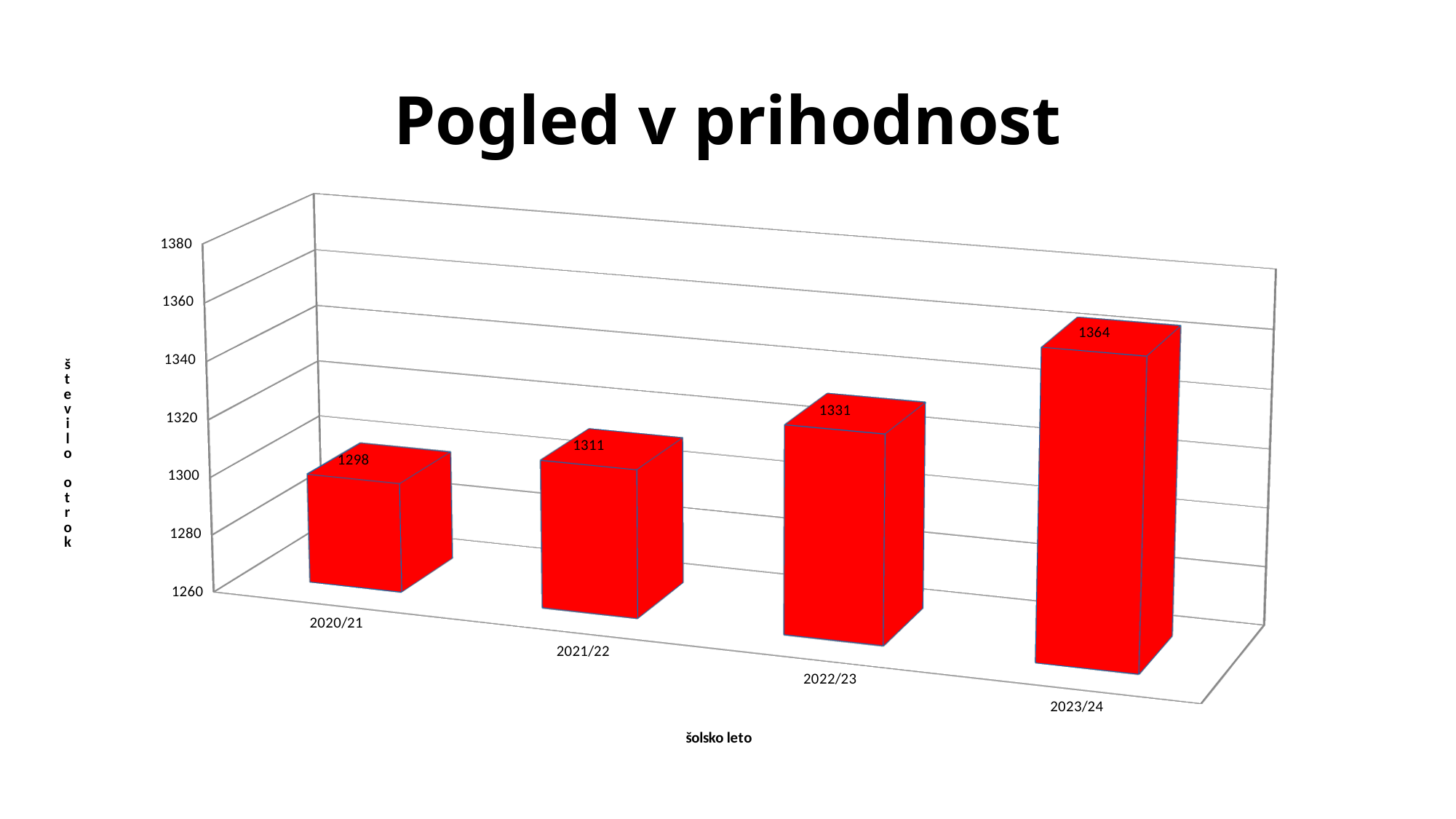
What is the value for 2022/23? 1331 Which school year has the lowest value? 2020/21 How many school years are shown on the chart? 4 Which school year has the highest value? 2023/24 What kind of chart is shown on the slide? bar chart What is the difference between the values for 2023/24 and 2020/21? 66 What is the value for 2023/24? 1364 Do the values rise or fall from 2020/21 to 2023/24? rise What is the value for 2021/22? 1311 Which is larger, the value for 2021/22 or the value for 2022/23? 2022/23 What is the difference between the values for 2022/23 and 2021/22? 20 What is the value for 2020/21? 1298